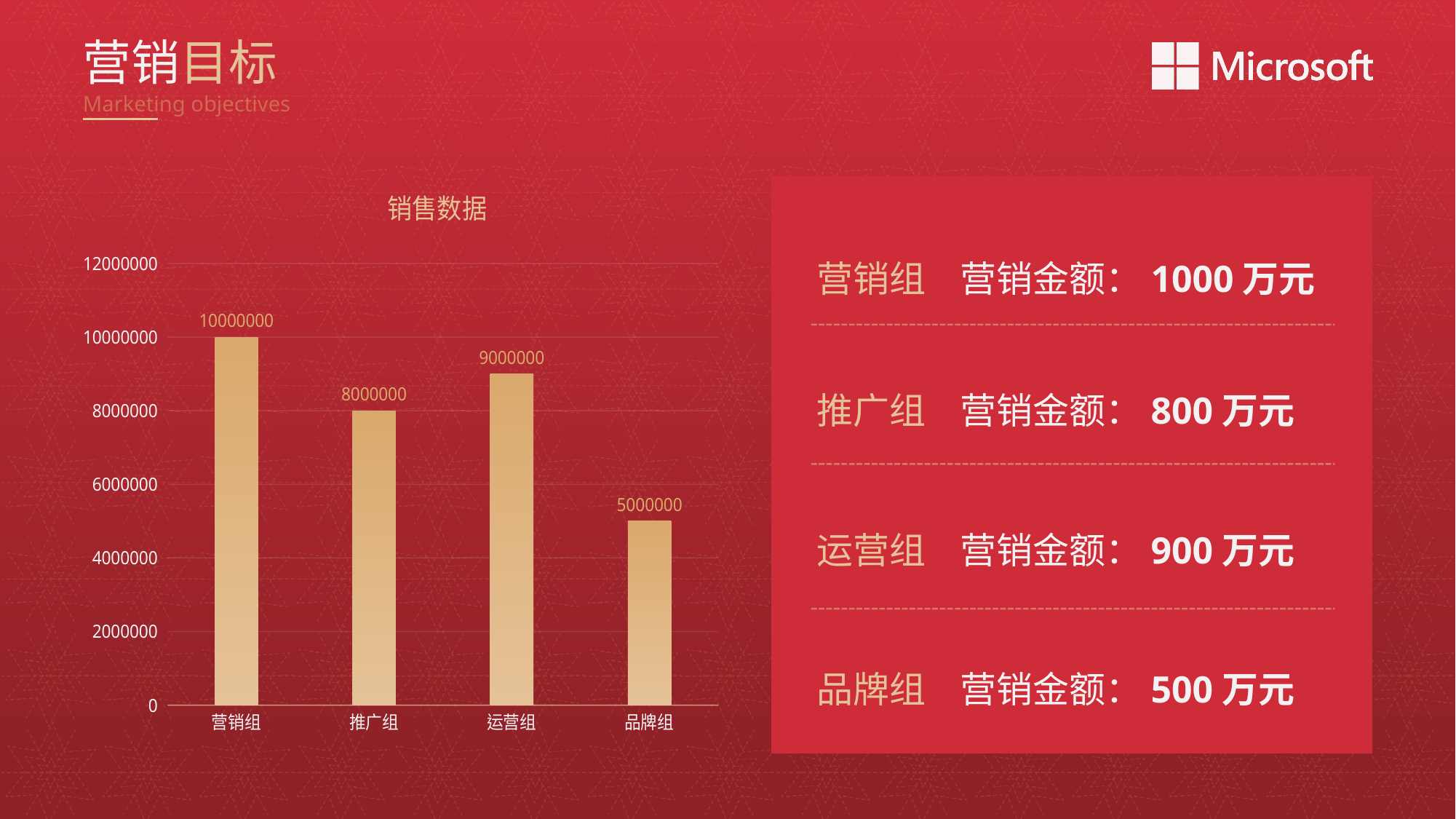
What is the difference between the values for 营销组 and 品牌组 in the 销售数据 chart? 5000000 Which is larger in the 销售数据 chart, the value for 推广组 or the value for 运营组? 运营组 What kind of chart is the 销售数据 chart? bar chart What is the value for 运营组 in the 销售数据 chart? 9000000 What is the value for 营销组 in the 销售数据 chart? 10000000 Which category has the highest value in the 销售数据 chart? 营销组 Which category has the lowest value in the 销售数据 chart? 品牌组 What is the difference between the values for 运营组 and 推广组 in the 销售数据 chart? 1000000 How many categories are shown in the 销售数据 chart? 4 What is the title of the chart on the slide? 销售数据 What is the value for 品牌组 in the 销售数据 chart? 5000000 What is the value for 推广组 in the 销售数据 chart? 8000000